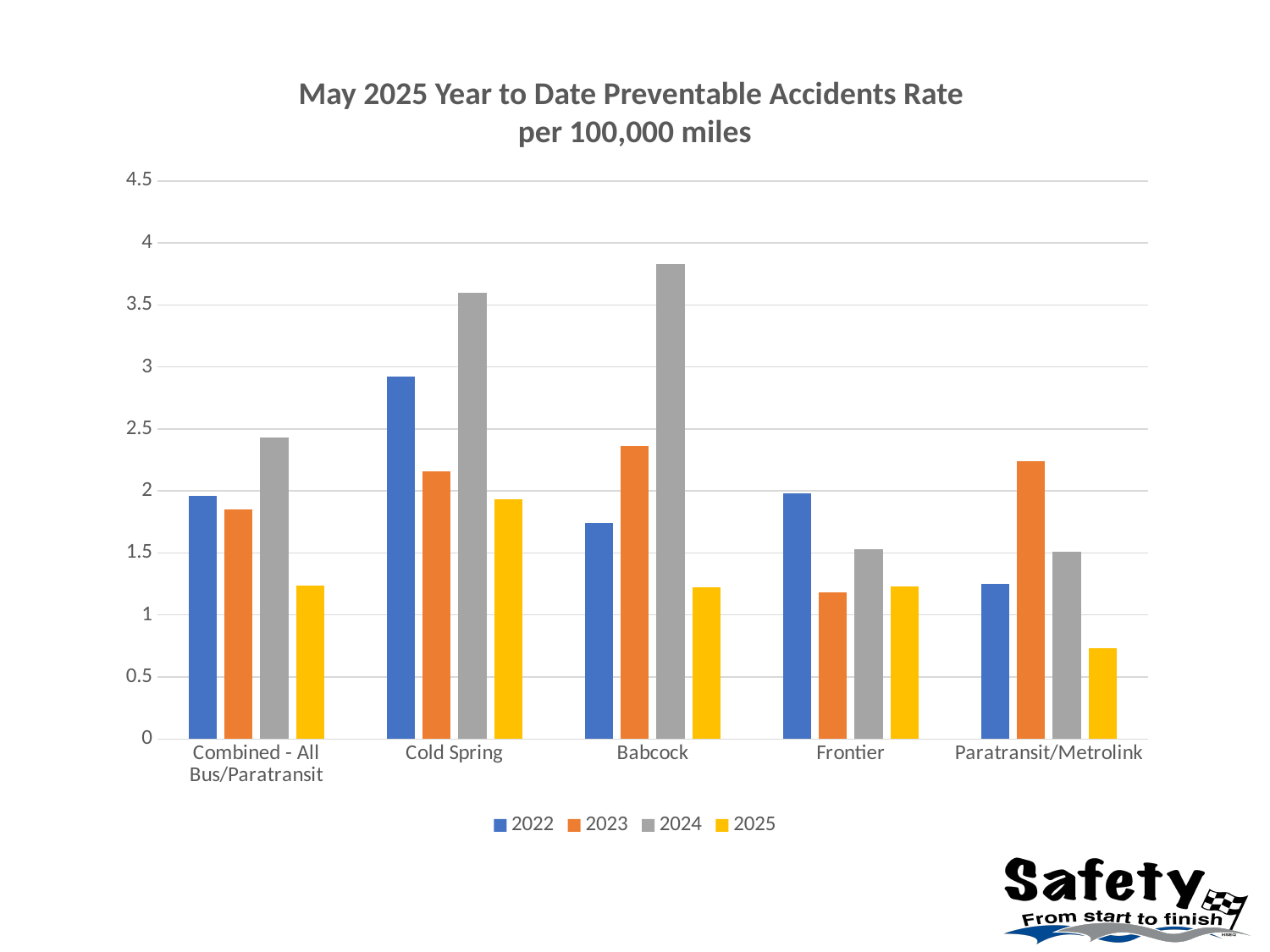
How many series does the legend list? 4 Is the 2025 value for Paratransit/Metrolink greater or less than 1? less For Frontier, which is larger: the 2023 value or the 2024 value? 2024 Which category has the lowest 2025 bar? Paratransit/Metrolink How many categories are shown along the x axis? 5 Which category has the highest 2024 bar? Babcock What is the title of the chart? May 2025 Year to Date Preventable Accidents Rate per 100,000 miles Is the 2024 value for Babcock greater or less than 3.5? greater For Cold Spring, which is larger: the 2022 value or the 2023 value? 2022 Is the 2022 value for Cold Spring greater or less than 2.5? greater What kind of chart is shown on the slide? Bar chart For Cold Spring, which year has the highest bar? 2024